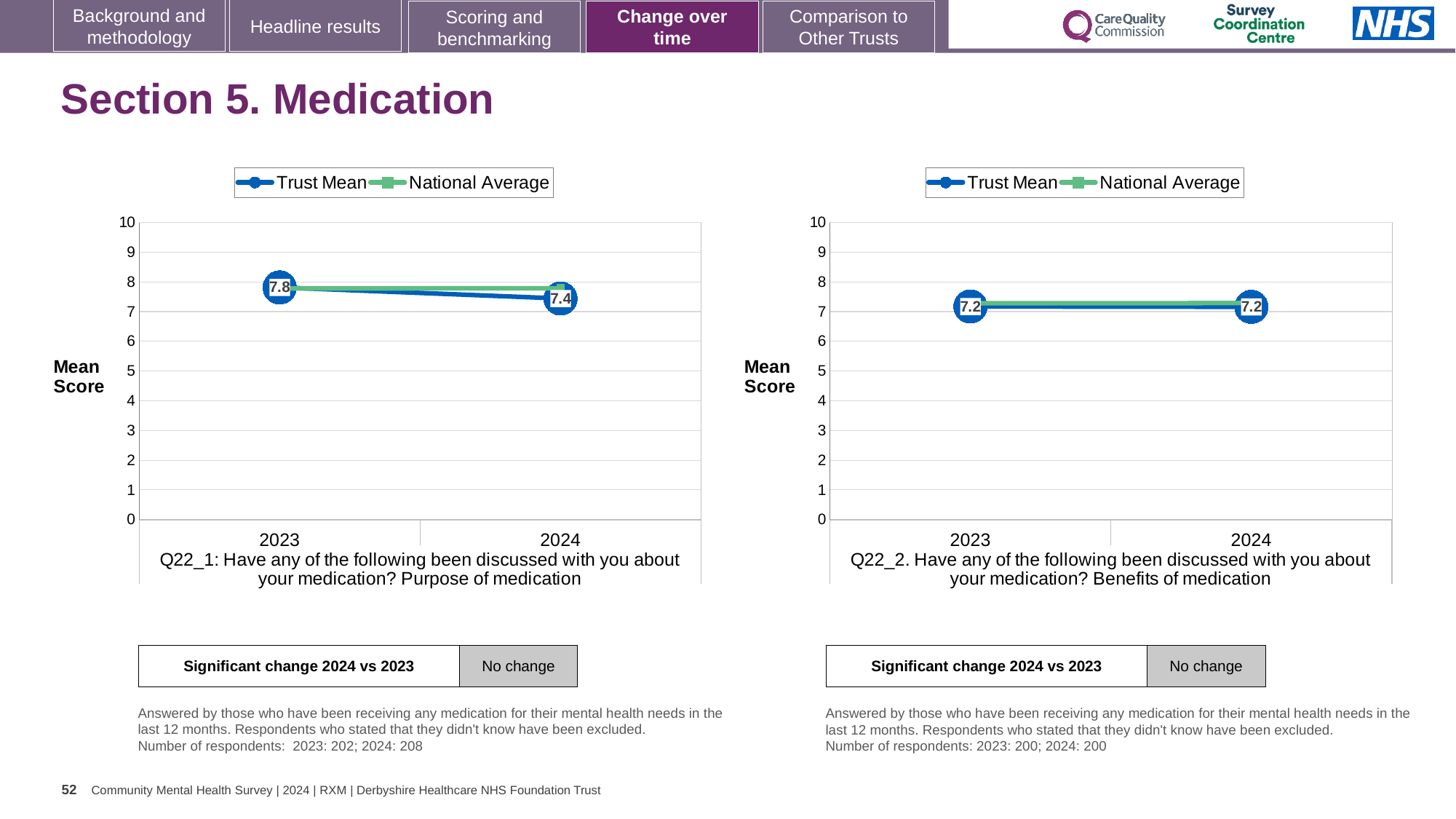
In the Q22_1 chart on the left, by how much did the Trust Mean change from 2023 to 2024? 0.4 How many series does the legend of the Q22_2 chart on the right list? 2 How many years are plotted on the x axis of the Q22_1 chart on the left? 2 What kind of chart is the Q22_1 chart on the left? line chart In the Q22_2 chart on the right, is the National Average value for 2024 greater or less than 5? greater In the Q22_2 chart on the right, does the Trust Mean rise, fall or stay the same from 2023 to 2024? stay the same In the Q22_1 chart on the left, which year has the higher Trust Mean, 2023 or 2024? 2023 In the Q22_2 chart on the right, what is the Trust Mean score for 2024? 7.2 In the Q22_2 chart on the right, what is the Trust Mean score for 2023? 7.2 In the Q22_1 chart on the left, what is the Trust Mean score for 2024? 7.4 In the Q22_1 chart on the left, what is the Trust Mean score for 2023? 7.8 In the Q22_1 chart on the left, does the Trust Mean rise or fall from 2023 to 2024? fall